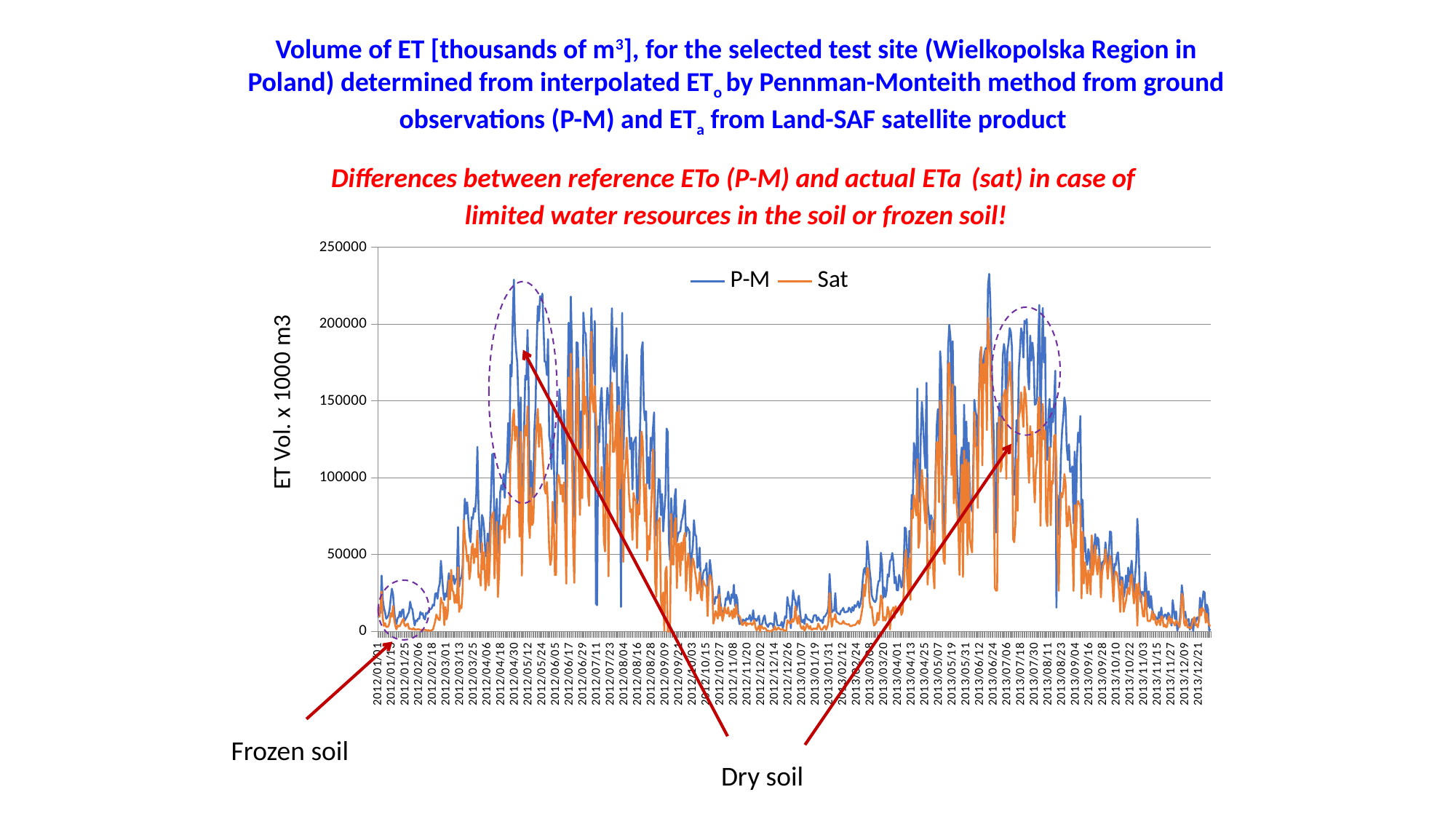
What kind of chart is shown on the slide? Line chart Do the P-M values generally rise or fall from 2012/01/01 to 2012/06/29? rise Is the highest value of the P-M series greater or less than 200000? greater What is the highest tick value shown on the vertical axis? 250000 Do the P-M values generally rise or fall from 2013/07/18 to 2013/12/21? fall How many series does the chart legend list? 2 Which series is drawn in orange on the chart? Sat What is the label of the vertical axis of the chart? ET Vol. x 1000 m3 What are the two series named in the chart legend? P-M and Sat Is the highest value of the Sat series greater or less than 150000? greater Which series reaches the higher peak values overall, P-M or Sat? P-M